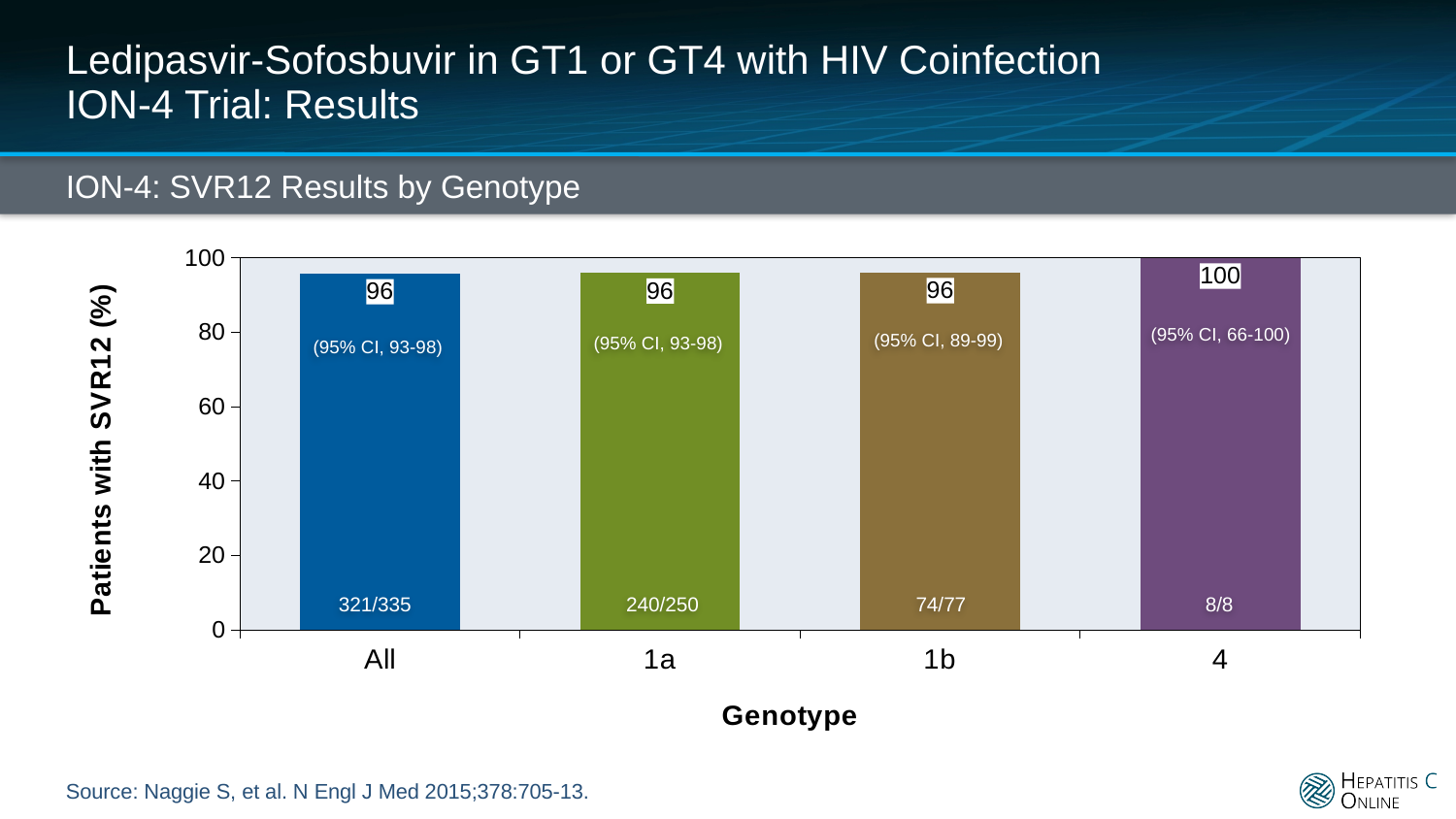
What kind of chart is shown on the slide? Bar chart What is the SVR12 rate for the 'All' genotype group? 96 What is the label of the y axis? Patients with SVR12 (%) How many genotype categories are shown on the x axis? 4 Which genotype category has the highest SVR12 rate? 4 What fraction of patients is shown at the bottom of the 'All' bar? 321/335 What is the SVR12 rate for genotype 4? 100 What is the 95% CI shown for genotype 4? 66-100 What is the SVR12 rate for genotype 1b? 96 Is the SVR12 rate for genotype 1b greater or less than 80? greater What is the title of the chart? ION-4: SVR12 Results by Genotype What is the difference between the SVR12 rate for genotype 4 and genotype 1a? 4